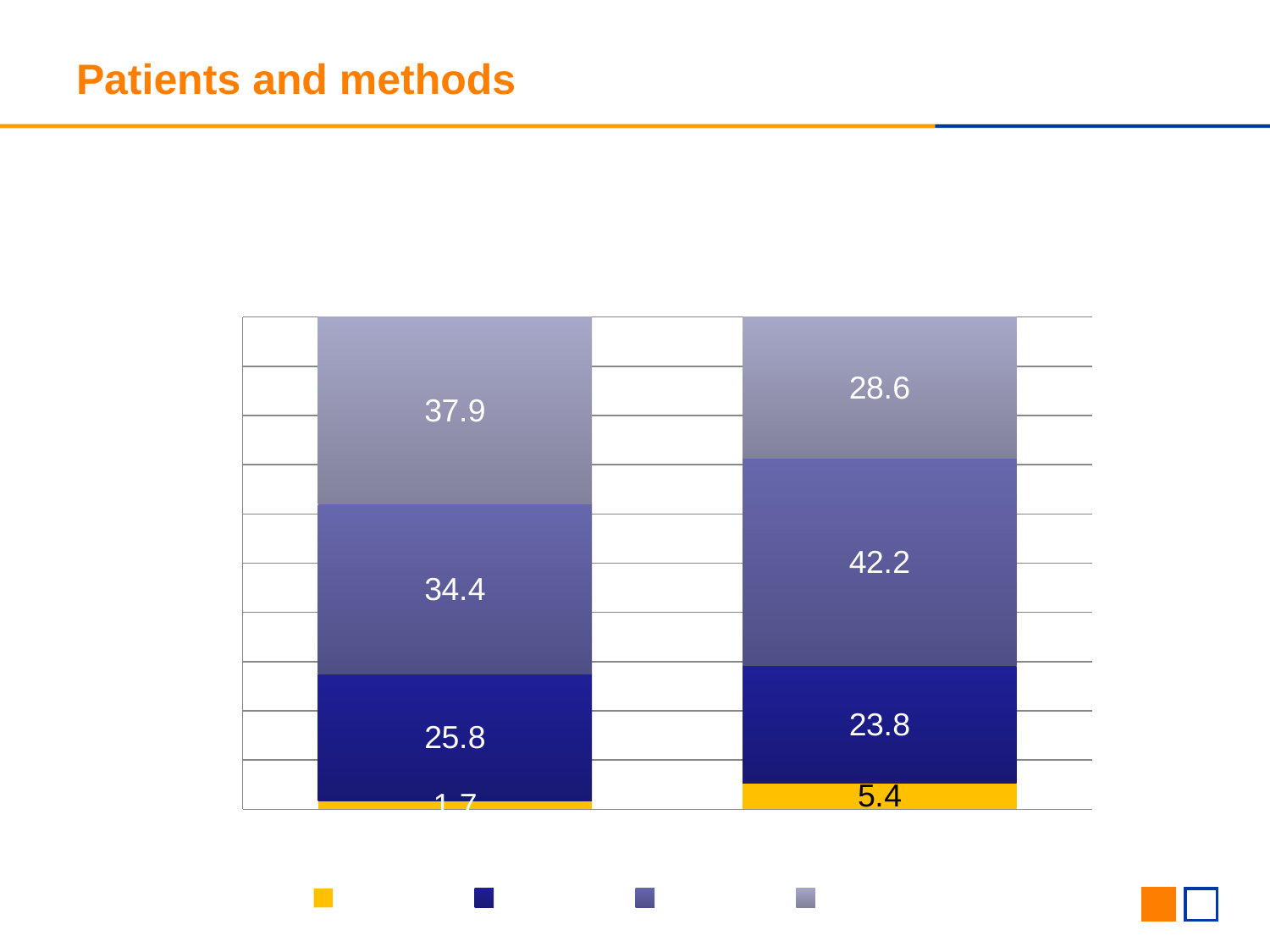
What is the value of the medium blue segment of the left bar? 34.4 What is the value of the medium blue segment of the right bar? 42.2 What is the value of the top (light grey-blue) segment of the left bar? 37.9 What is the value of the dark blue segment of the left bar? 25.8 Which is larger: the dark blue segment of the left bar or the dark blue segment of the right bar? the left bar (25.8) How many bars are plotted in the chart? 2 Which segment of the right bar has the largest value? the medium blue segment (42.2) What kind of chart is shown on the slide? stacked bar chart What is the difference between the medium blue segment of the right bar (42.2) and the medium blue segment of the left bar (34.4)? 7.8 How many colour swatches does the legend below the chart show? 4 What is the value of the top (light grey-blue) segment of the right bar? 28.6 What is the value of the yellow segment at the bottom of the right bar? 5.4